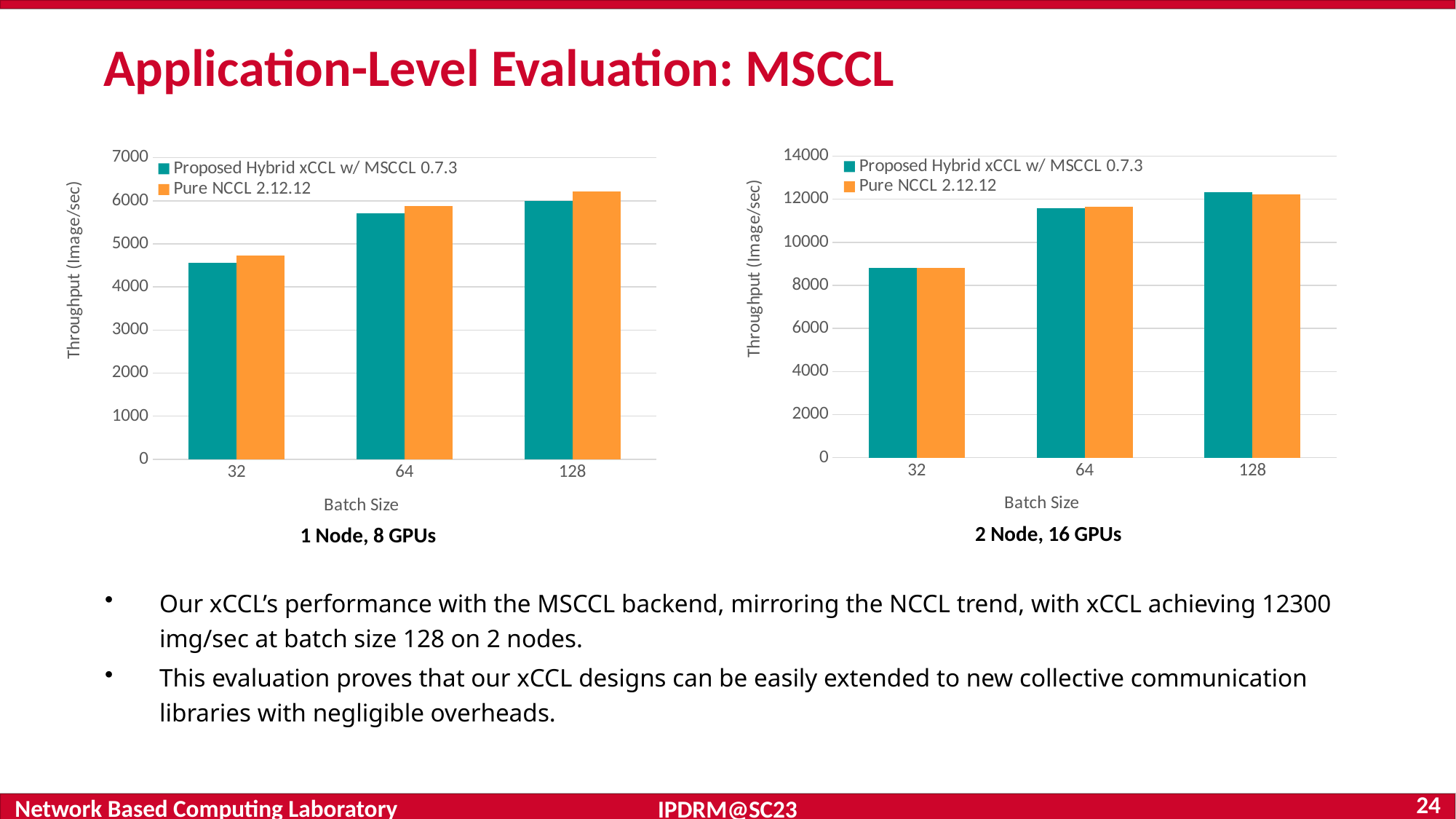
What is the y-axis label of the '1 Node, 8 GPUs' chart? Throughput (Image/sec) In the '2 Node, 16 GPUs' chart, is the value for Proposed Hybrid xCCL w/ MSCCL 0.7.3 at batch size 128 greater or less than 12000? greater How many batch sizes are shown on the x axis of the '1 Node, 8 GPUs' chart? 3 In the '1 Node, 8 GPUs' chart, is the value for Pure NCCL 2.12.12 at batch size 128 greater or less than 6000? greater How many series does the legend of the '2 Node, 16 GPUs' chart list? 2 In the '1 Node, 8 GPUs' chart, which series has the higher value at batch size 128? Pure NCCL 2.12.12 In the '2 Node, 16 GPUs' chart, does throughput rise or fall as batch size increases? rise What kind of chart is the '1 Node, 8 GPUs' chart? bar chart In the '1 Node, 8 GPUs' chart, which bar is the lowest? Proposed Hybrid xCCL w/ MSCCL 0.7.3 at batch size 32 In the '1 Node, 8 GPUs' chart, is the value for Proposed Hybrid xCCL w/ MSCCL 0.7.3 at batch size 32 greater or less than 5000? less In the '2 Node, 16 GPUs' chart, which colour represents Pure NCCL 2.12.12? orange